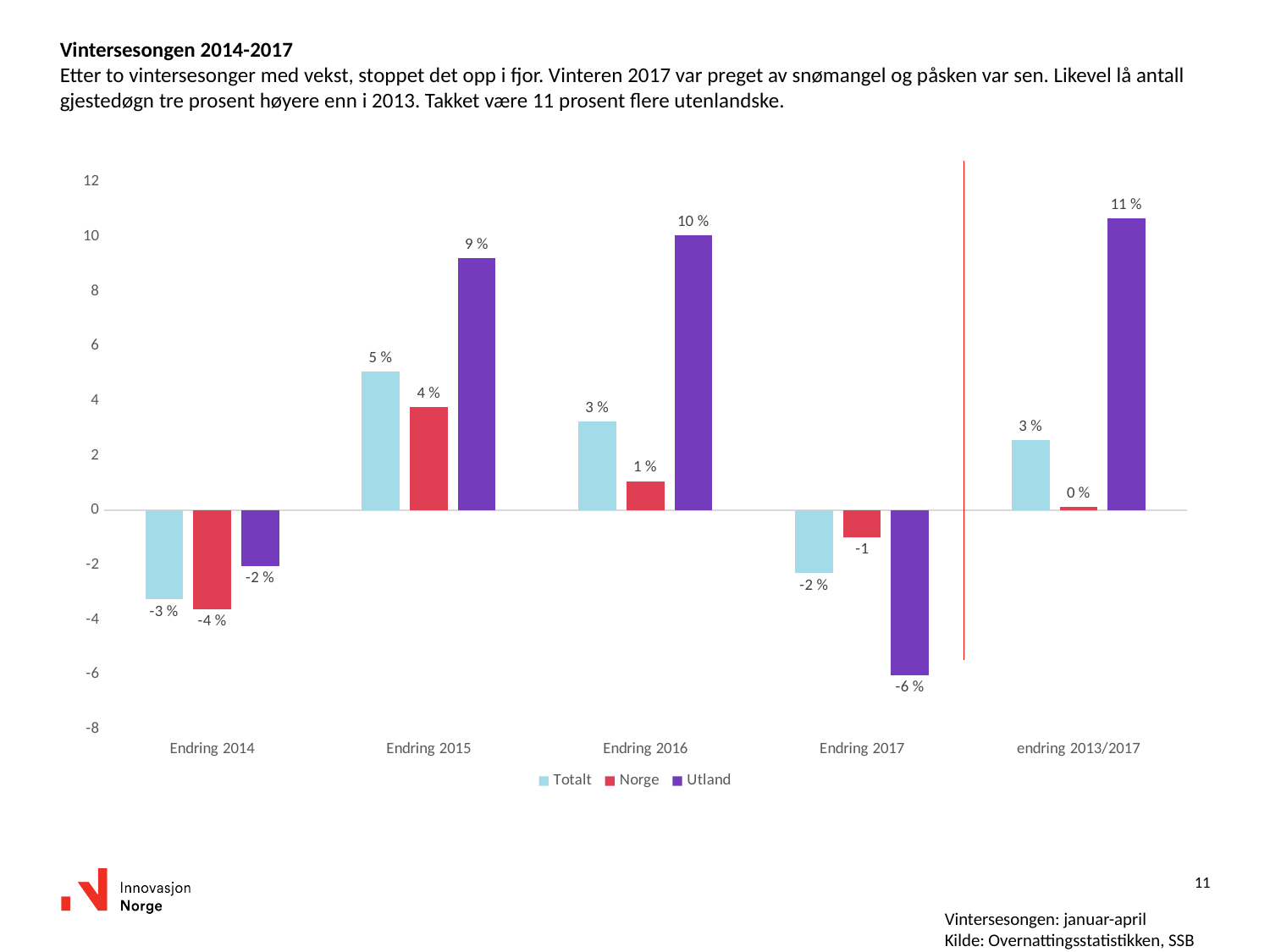
What is the difference between the Utland and Norge values in Endring 2016? 9 % What is the value for Totalt in Endring 2015? 5 % How many series does the legend list? 3 Which category has the highest value for Utland? endring 2013/2017 Which category has the lowest value for Utland? Endring 2017 What is the data label shown for Norge in Endring 2017? -1 What is the value for Utland in Endring 2016? 10 % What is the value for Norge in Endring 2014? -4 % How many categories are shown on the x axis? 5 Which is larger in Endring 2015, the value for Utland or the value for Norge? Utland What is the value for Norge in endring 2013/2017? 0 % What kind of chart is shown on the slide? Bar chart